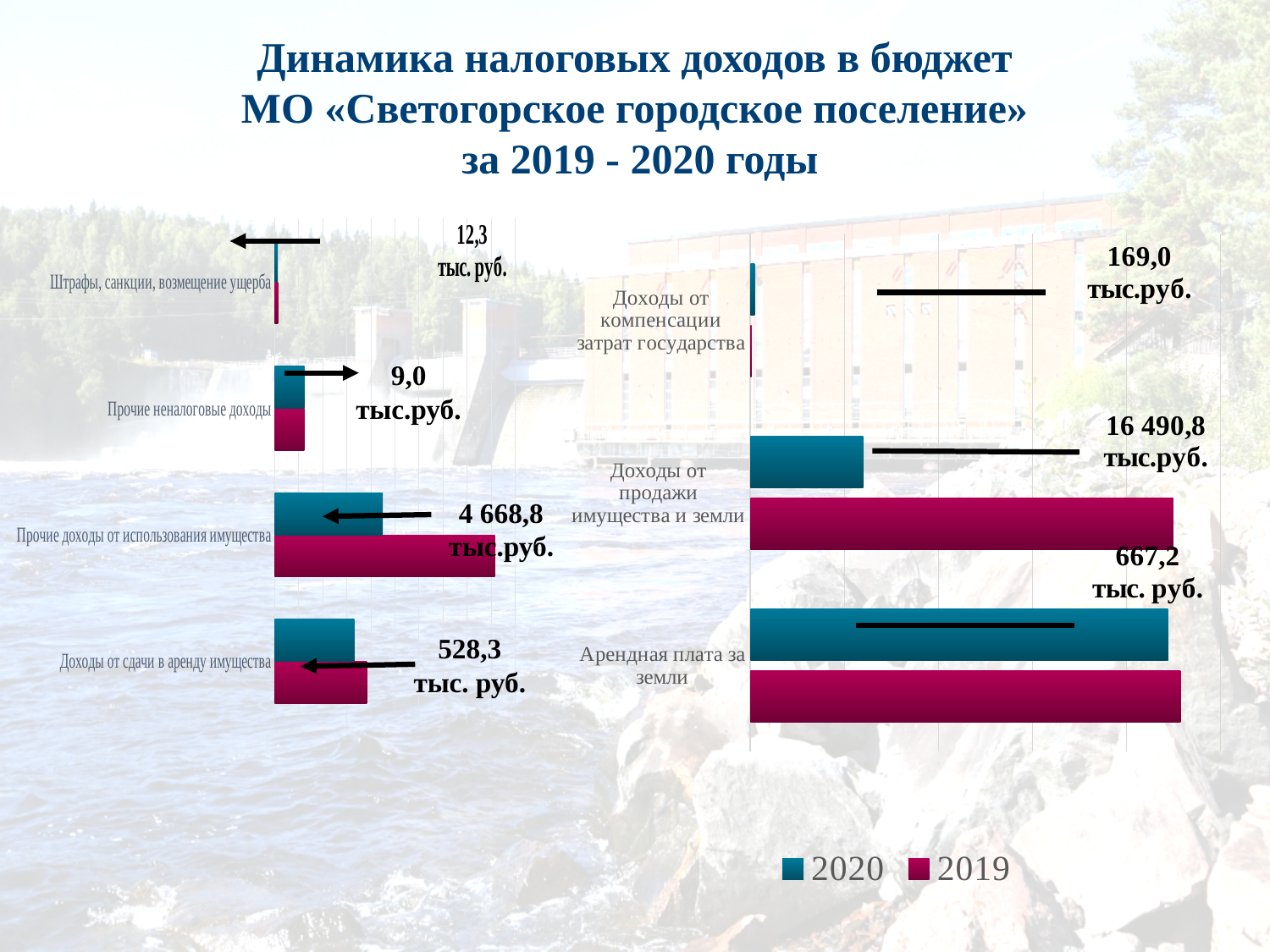
In the chart on the right side of the slide, for Доходы от продажи имущества и земли, which year has the larger value, 2019 or 2020? 2019 In the chart on the left side of the slide, which category has the shortest bars? Штрафы, санкции, возмещение ущерба In the chart on the right side of the slide, which category has the shortest bars? Доходы от компенсации затрат государства In the chart on the left side of the slide, for Прочие доходы от использования имущества, which year has the larger value, 2019 or 2020? 2019 How many series does the legend at the bottom of the slide list? 2 In the chart on the right side of the slide, what change is annotated next to Доходы от продажи имущества и земли? 16 490,8 тыс.руб. Which years are listed in the legend? 2020 and 2019 What kind of chart is the chart on the left side of the slide? bar chart In the chart on the left side of the slide, which category has the longest 2019 bar? Прочие доходы от использования имущества How many categories are shown in the chart on the right side of the slide? 3 In the chart on the right side of the slide, which category has the longest 2020 bar? Арендная плата за земли How many categories are shown in the chart on the left side of the slide? 4